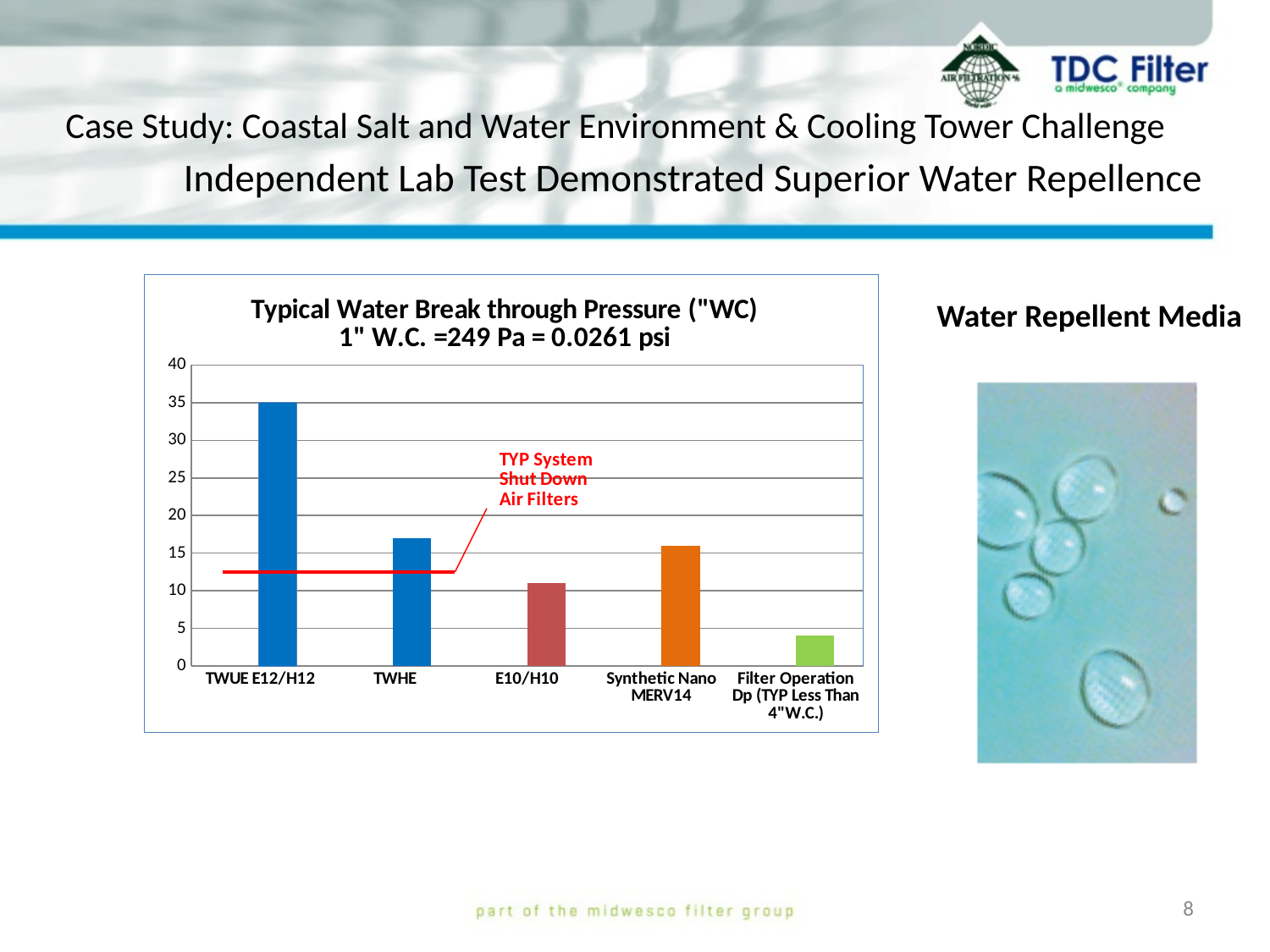
Is the value for E10/H10 greater or less than 15? less Which category has the highest water break through pressure? TWUE E12/H12 Is the value for Filter Operation Dp (TYP Less Than 4"W.C.) greater or less than 5? less Is the value for TWHE greater or less than 15? greater Which is larger, the value for TWUE E12/H12 or the value for TWHE? TWUE E12/H12 What is the value for TWUE E12/H12? 35 How many categories are plotted on the x axis of the chart? 5 Which is larger, the value for E10/H10 or the value for Synthetic Nano MERV14? Synthetic Nano MERV14 What does the red horizontal line on the chart represent, according to its label? TYP System Shut Down Air Filters What kind of chart is shown on the slide? bar chart Which category has the lowest value in the chart? Filter Operation Dp (TYP Less Than 4"W.C.)